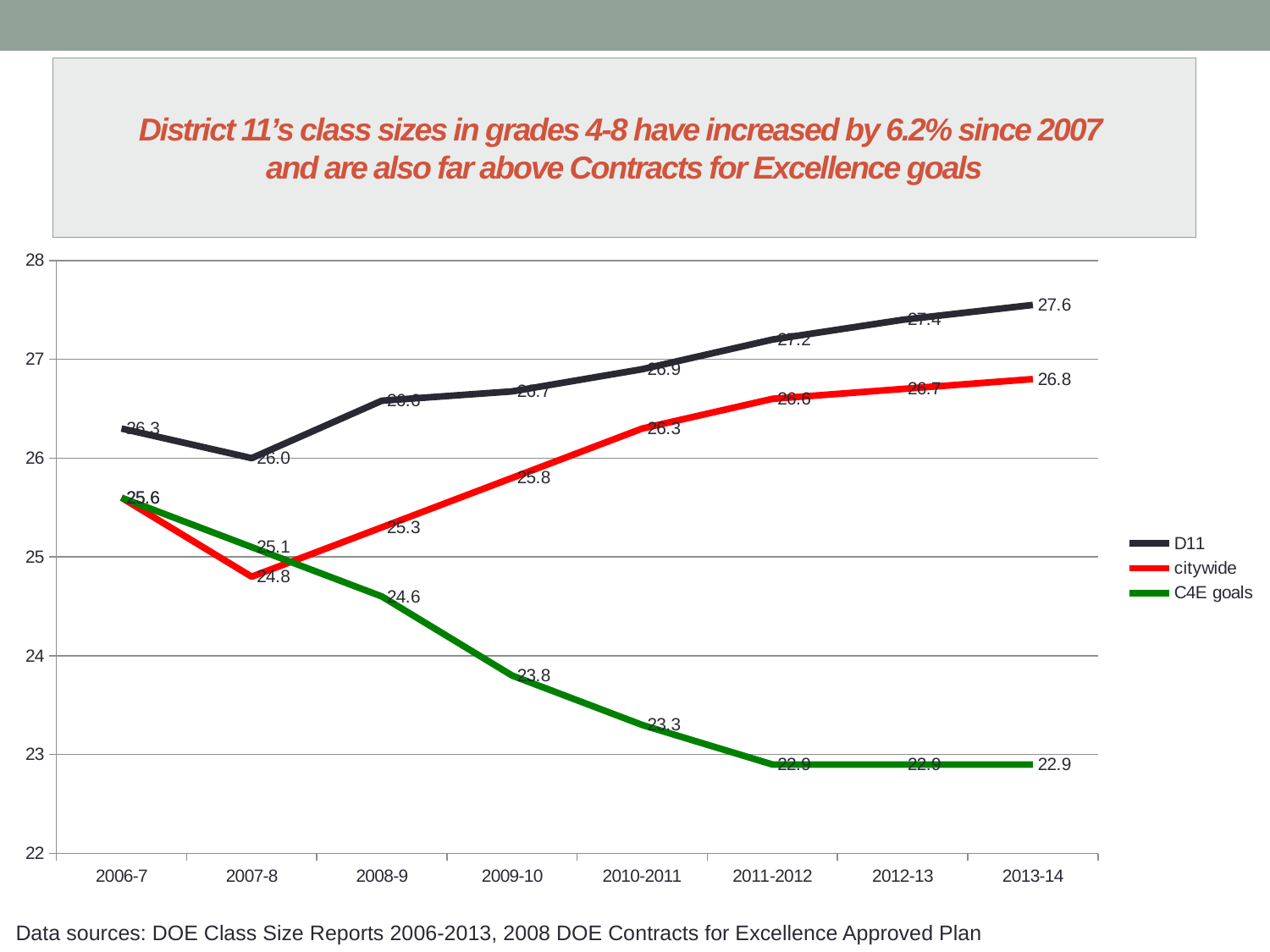
What is the difference between the D11 and citywide values in 2013-14? 0.8 What is the D11 value for 2013-14? 27.6 In which school year is the citywide value lowest? 2007-8 What kind of chart is shown on the slide? line chart What is the difference between the D11 and C4E goals values in 2013-14? 4.7 Do the C4E goals values rise or fall across the school years? fall What is the C4E goals value for 2009-10? 23.8 What is the citywide value for 2007-8? 24.8 How many school years are shown on the x axis? 8 What is the citywide value for 2013-14? 26.8 How many series does the legend list? 3 In 2007-8, which is larger: the citywide value or the C4E goals value? C4E goals